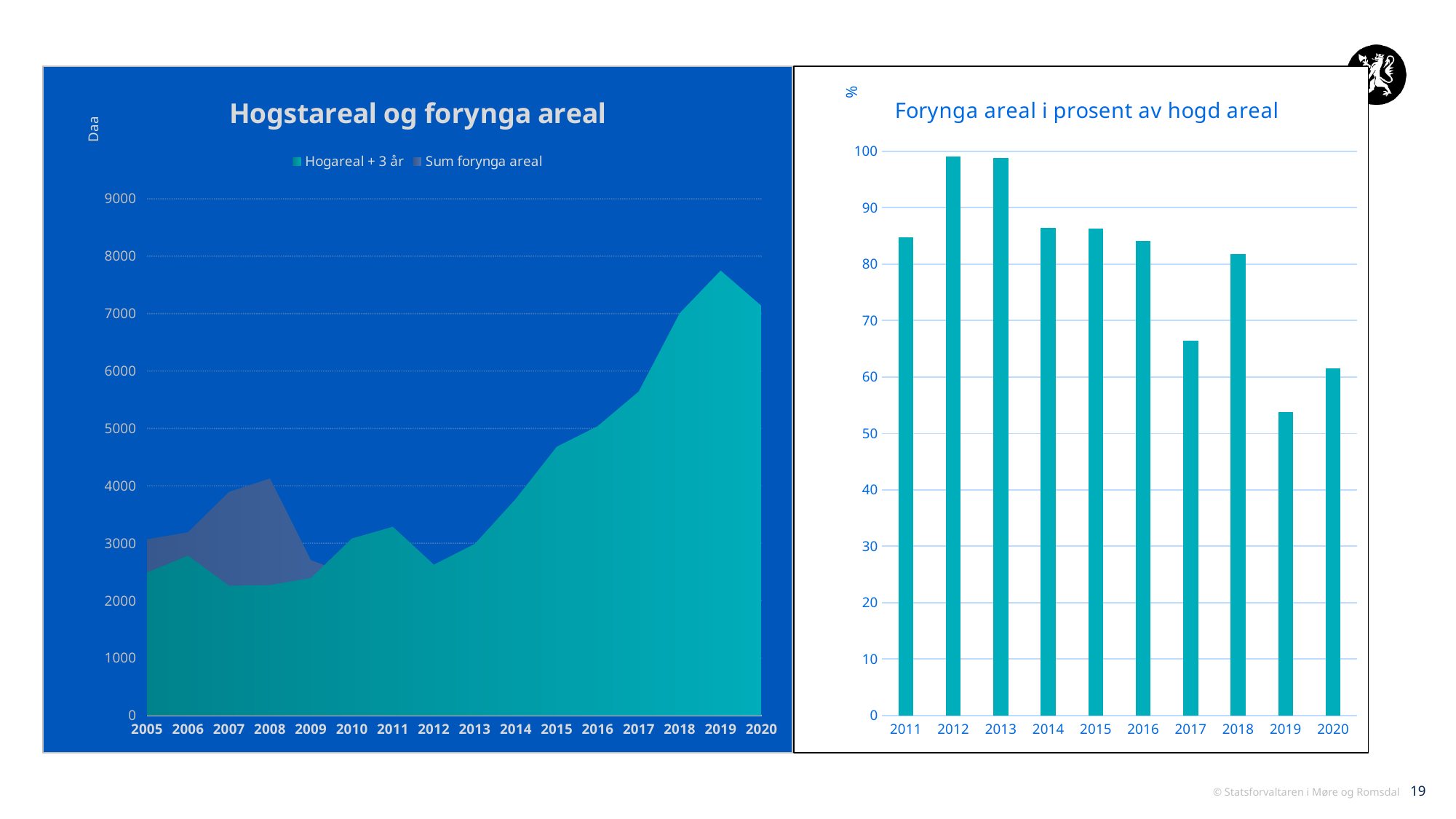
In the left chart 'Hogstareal og forynga areal', in which year does the 'Hogareal + 3 år' series reach its highest value? 2019 In the right chart 'Forynga areal i prosent av hogd areal', is the value for 2017 greater or less than 70? less How many years are shown on the x axis of the right chart 'Forynga areal i prosent av hogd areal'? 10 In the right chart 'Forynga areal i prosent av hogd areal', which year has the lowest value? 2019 What type of chart is the left chart titled 'Hogstareal og forynga areal'? area chart What is the y-axis unit label on the left chart 'Hogstareal og forynga areal'? Daa How many years are shown on the x axis of the left chart 'Hogstareal og forynga areal'? 16 In the right chart 'Forynga areal i prosent av hogd areal', is the value for 2011 greater or less than 80? greater How many series does the legend of the left chart 'Hogstareal og forynga areal' list? 2 In the left chart 'Hogstareal og forynga areal', is the 'Hogareal + 3 år' value for 2019 greater or less than 7000? greater In the right chart 'Forynga areal i prosent av hogd areal', which is larger, the value for 2012 or the value for 2019? 2012 What type of chart is the right chart titled 'Forynga areal i prosent av hogd areal'? bar chart